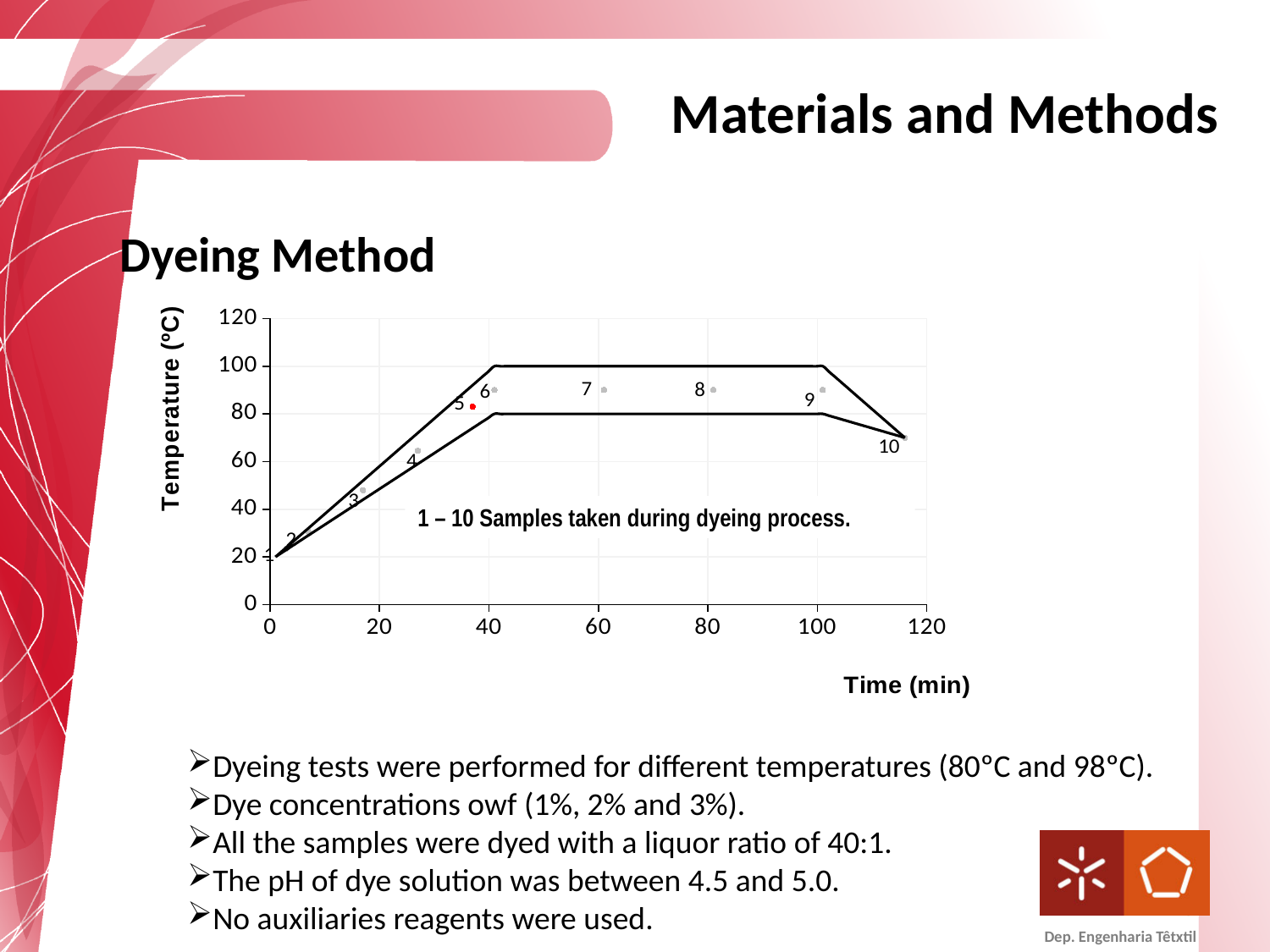
Which is higher, the temperature at sample 8 or at sample 10? sample 8 Is the temperature at sample 2 greater or less than 40? less How many numbered sample points are marked on the chart? 10 What is the label of the x axis of the chart? Time (min) What temperature does the lower dyeing curve hold during its plateau? 80 Is the temperature at sample 3 greater or less than 60? less How does the temperature change along the time axis from 0 to about 40 minutes? it rises What is the label of the y axis of the chart? Temperature (ºC) Is the temperature at sample 7 greater or less than 80? greater What kind of chart is shown on the slide? line chart